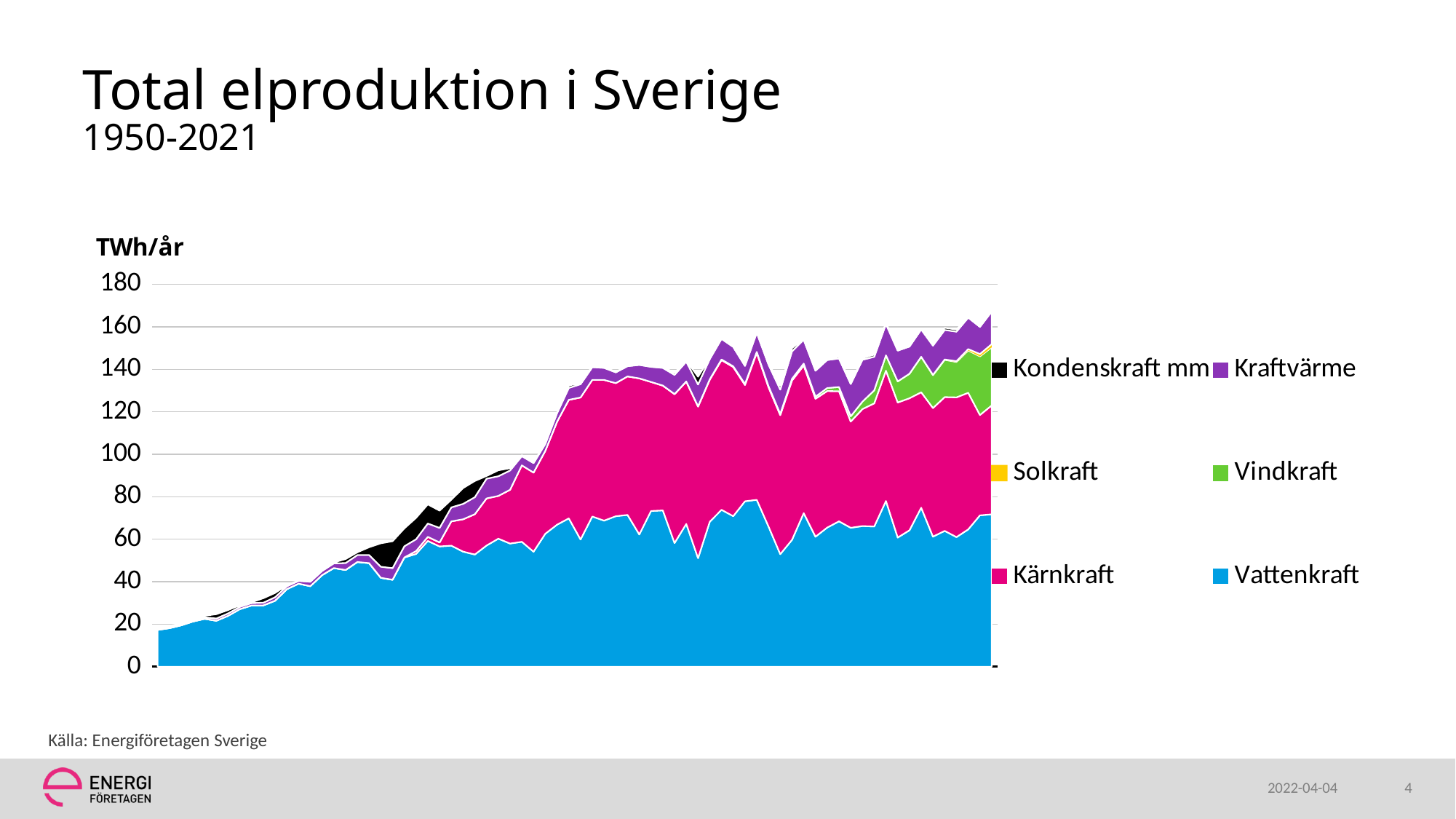
What is the highest value shown on the y axis? 180 At the right end of the chart, which is larger, the Vattenkraft layer or the Kärnkraft layer? Vattenkraft Which series forms the bottom layer of the stacked area chart? Vattenkraft What kind of chart is shown on the slide? Stacked area chart Is the total production at the right end of the chart greater or less than 140 TWh/år? greater Does total electricity production rise or fall overall from the left to the right of the chart? Rise How many series does the legend list? 6 What is the title of the chart on the slide? Total elproduktion i Sverige 1950-2021 Is the total production at the left end of the chart greater or less than 40 TWh/år? less Is the Vattenkraft value at the right end of the chart greater or less than 100 TWh/år? less